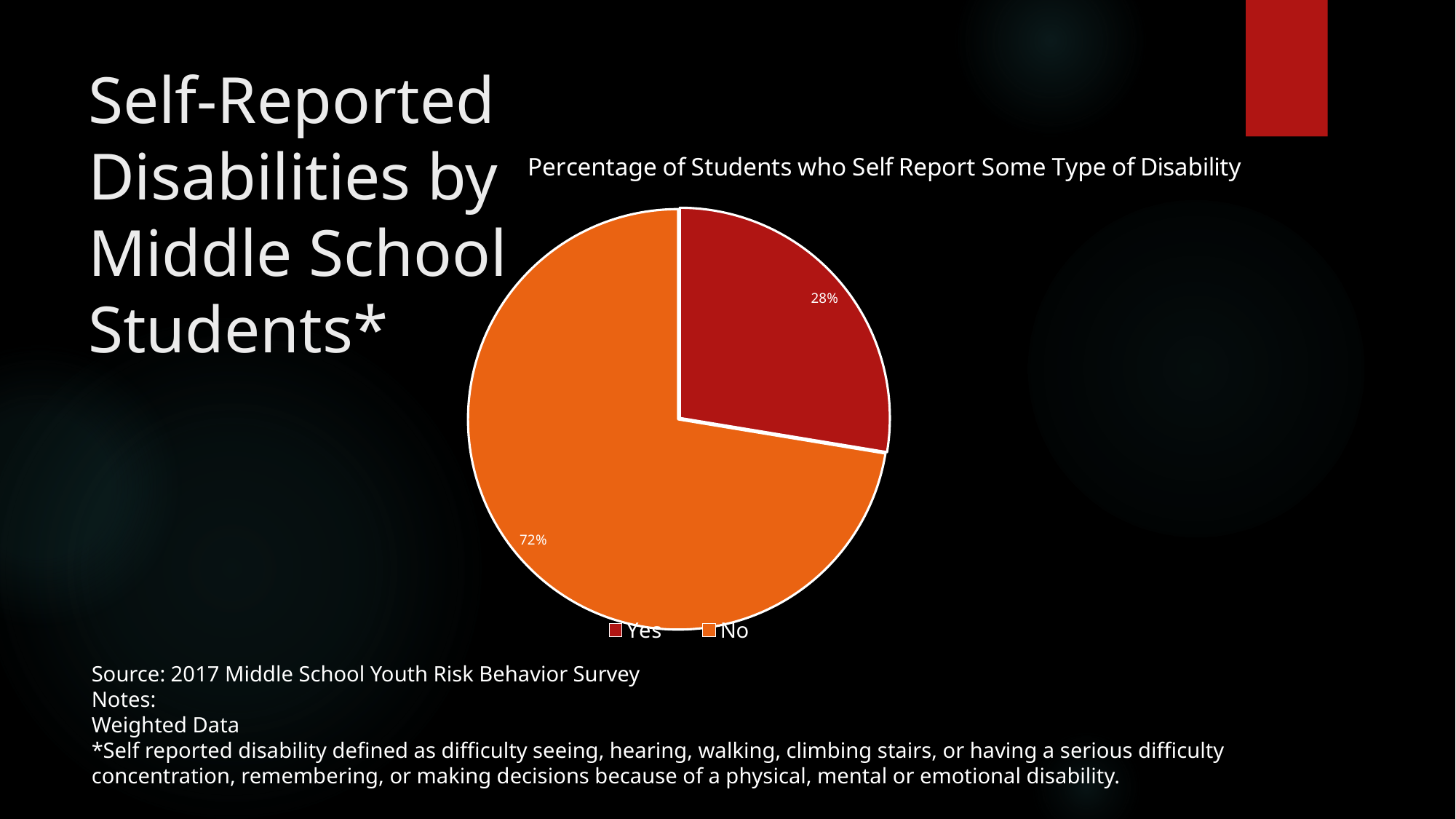
How many entries does the legend list? 2 Which slice is larger, "Yes" or "No"? No What is the difference in percentage points between the "No" and "Yes" slices? 44 Which category has the smallest share of the pie? Yes What is the title of the chart? Percentage of Students who Self Report Some Type of Disability What percentage of students answered "Yes" to self-reporting some type of disability? 28% How many slices does the pie chart have? 2 What percentage of students answered "No" to self-reporting some type of disability? 72% What kind of chart is shown on the slide? Pie chart What colour is the "No" slice in the pie chart? Orange What share of the pie does the "Yes" slice represent? 28% Which category has the largest share of the pie? No